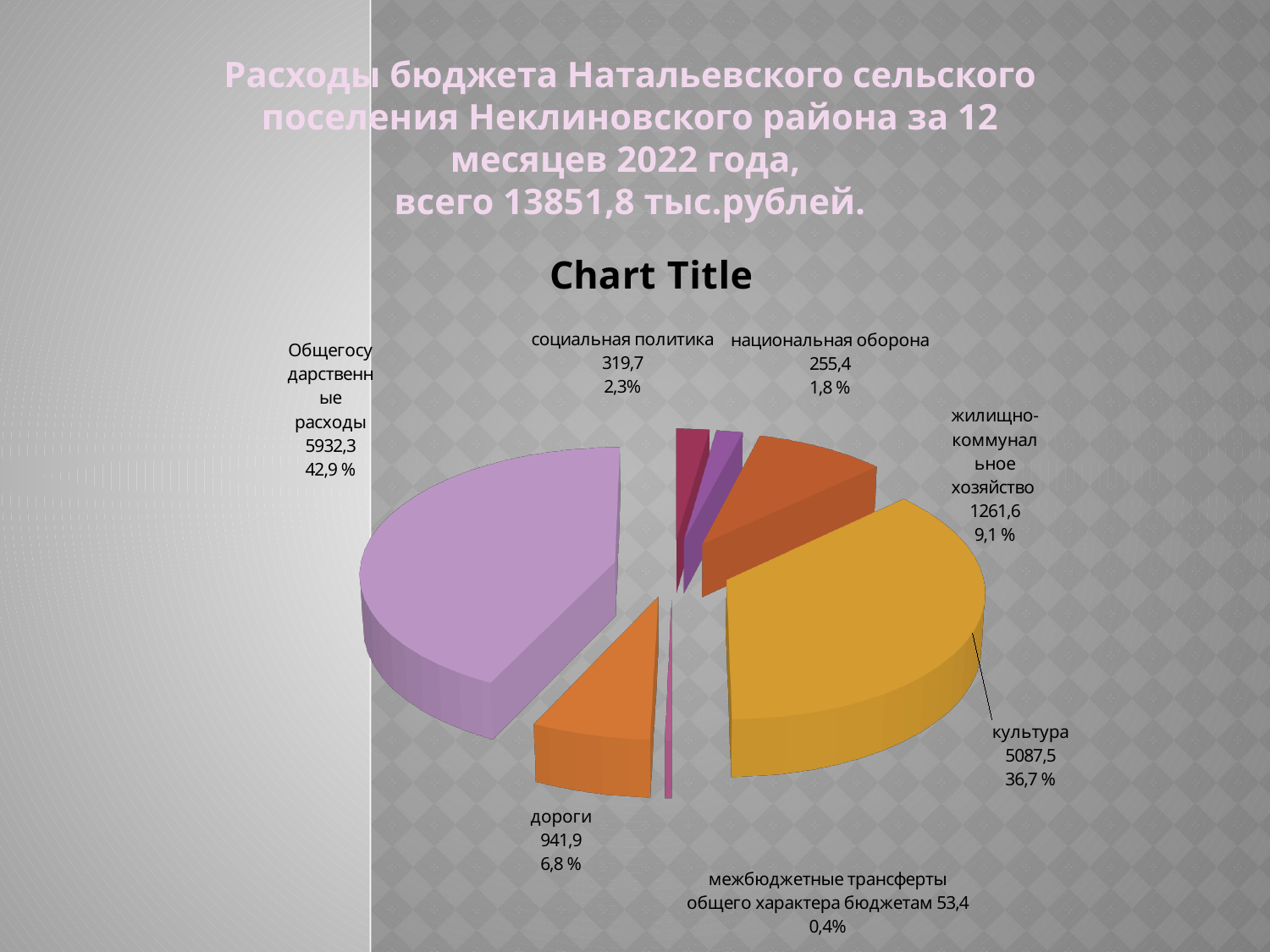
How many categories (slices) does the pie chart show? 7 What is the difference between the values for Общегосударственные расходы and культура? 844,8 What is the value for культура? 5087,5 Which category has the smallest slice? межбюджетные трансферты общего характера бюджетам What is the value for жилищно-коммунальное хозяйство? 1261,6 What kind of chart is shown on the slide? pie chart What share of the pie does социальная политика take? 2,3% What share of the pie does Общегосударственные расходы take? 42,9 % What is the title printed directly above the pie chart? Chart Title Which is larger, the value for национальная оборона or the value for социальная политика? социальная политика Which category has the largest slice? Общегосударственные расходы What is the value for дороги? 941,9